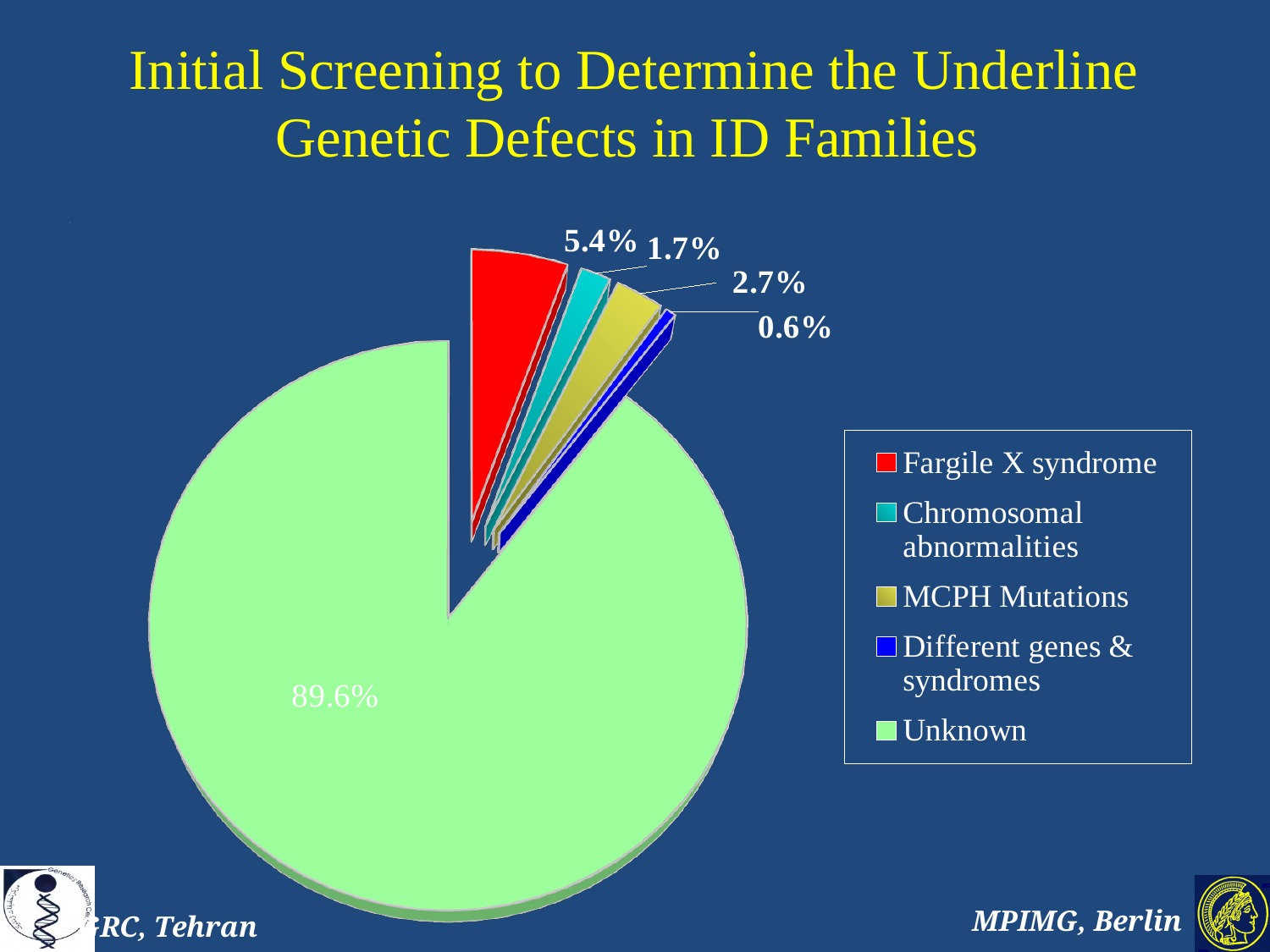
What share of the pie is labelled Unknown? 89.6% How many categories does the legend list? 5 What is the difference between the Fargile X syndrome share and the MCPH Mutations share? 2.7% What percentage is shown for Chromosomal abnormalities? 1.7% What percentage is shown for MCPH Mutations? 2.7% What kind of chart is shown on the slide? pie chart Which category has the smallest slice of the pie? Different genes & syndromes What colour is the slice for Fargile X syndrome? red What percentage is shown for Fargile X syndrome? 5.4% Which category has the largest slice of the pie? Unknown What percentage is shown for Different genes & syndromes? 0.6% Which is larger, the share for MCPH Mutations or the share for Chromosomal abnormalities? MCPH Mutations